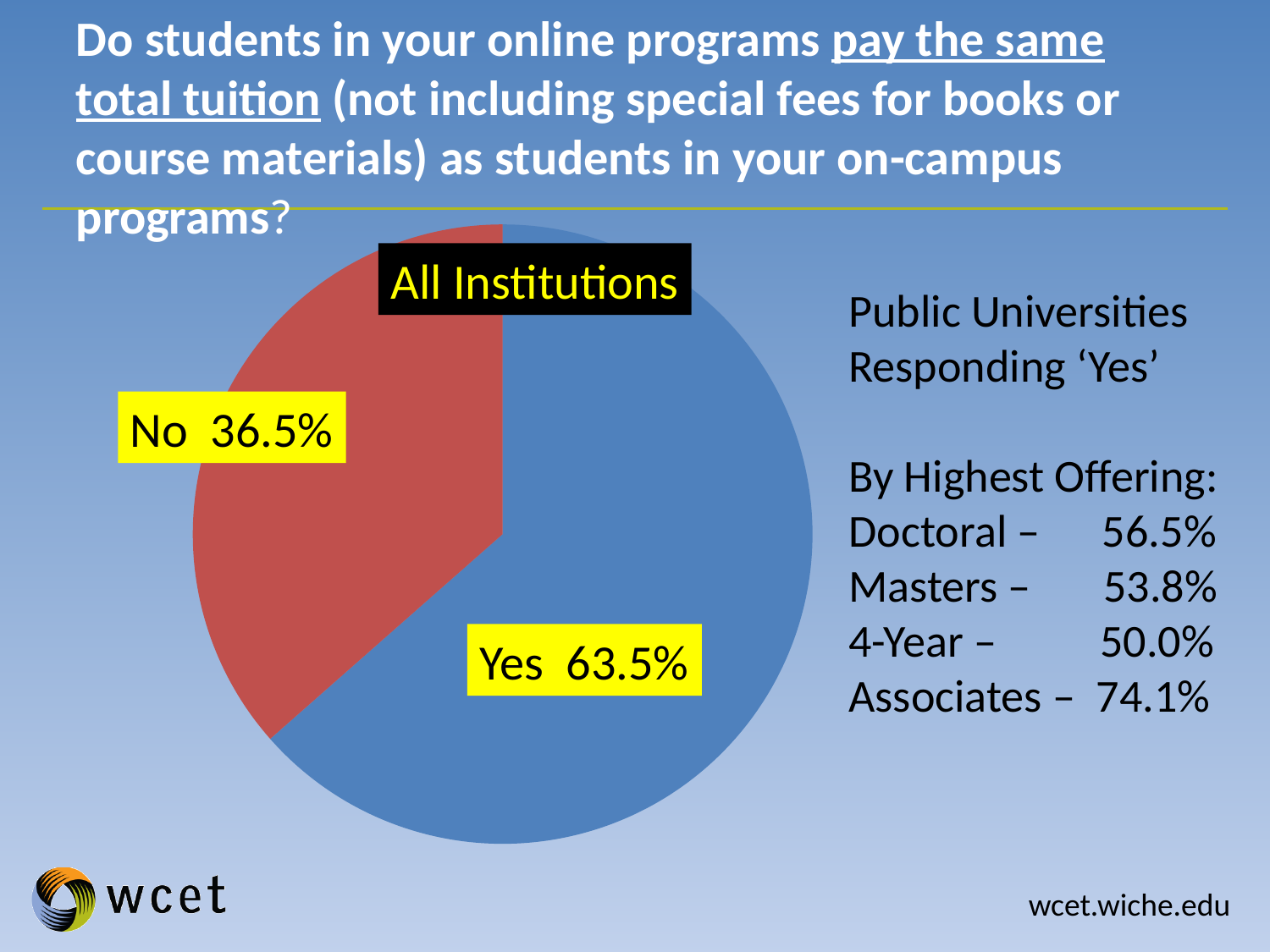
Is the 'Yes' share of the pie greater or less than 50%? greater Which response has the larger share of the pie, 'Yes' or 'No'? Yes Which response has the smallest slice of the pie? No What colour is the 'Yes' slice of the pie chart? blue What is the title shown on the pie chart? All Institutions What kind of chart is shown on the slide? pie chart What percentage of all institutions answered 'Yes'? 63.5% What percentage of all institutions answered 'No'? 36.5% What share of the pie does the 'No' slice represent? 36.5% What is the difference in percentage points between the 'Yes' and 'No' slices? 27 percentage points How many slices does the pie chart have? 2